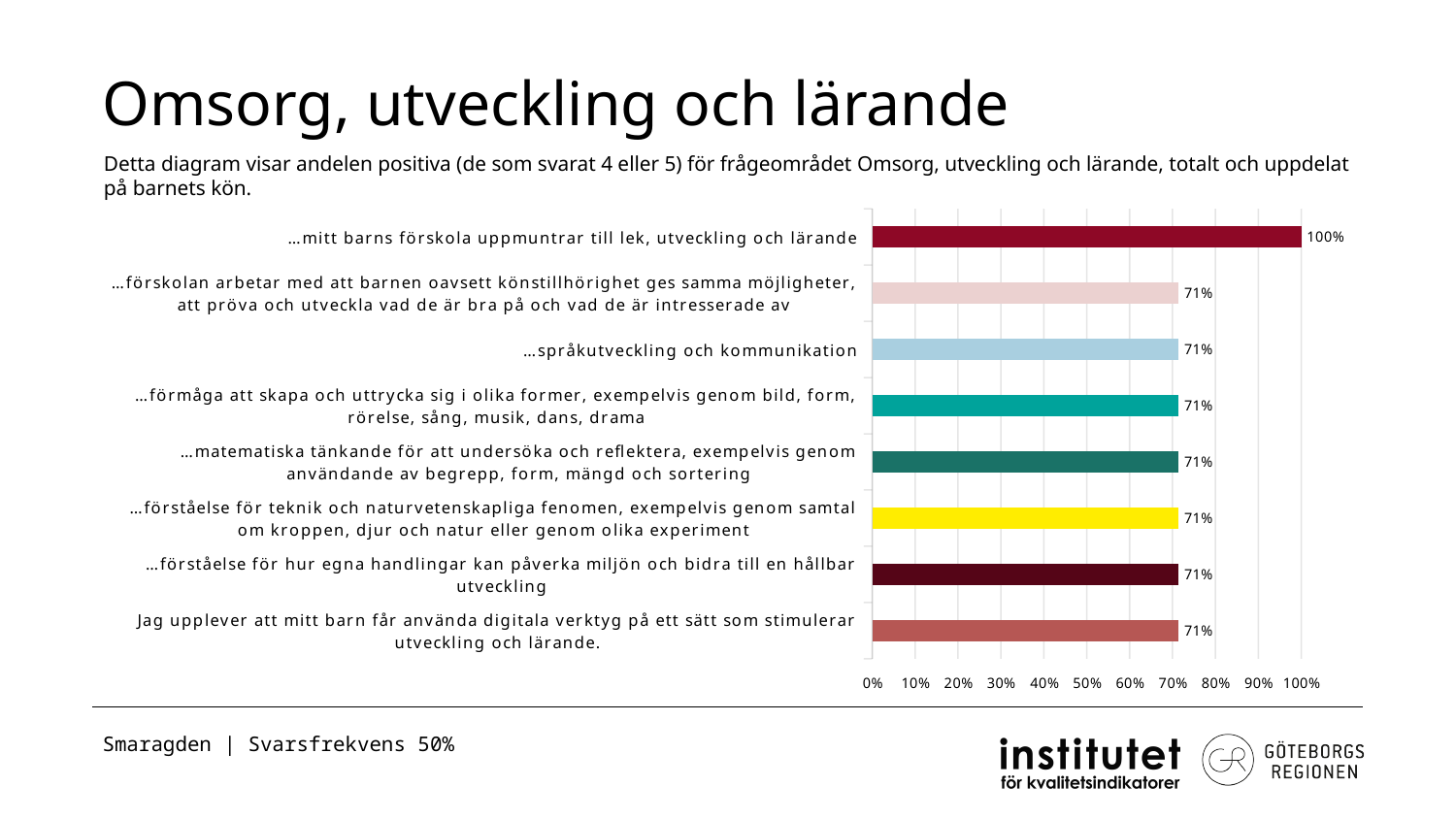
Is the value for "…förmåga att skapa och uttrycka sig i olika former, exempelvis genom bild, form, rörelse, sång, musik, dans, drama" greater or less than 50%? greater What is the value for "…mitt barns förskola uppmuntrar till lek, utveckling och lärande"? 100% Which category has the highest value? …mitt barns förskola uppmuntrar till lek, utveckling och lärande What is the difference between the value for "…mitt barns förskola uppmuntrar till lek, utveckling och lärande" and the value for "…språkutveckling och kommunikation"? 29% What kind of chart is shown on the slide? Bar chart Is the value for "…förståelse för teknik och naturvetenskapliga fenomen, exempelvis genom samtal om kroppen, djur och natur eller genom olika experiment" greater or less than 80%? less What is the value for "Jag upplever att mitt barn får använda digitala verktyg på ett sätt som stimulerar utveckling och lärande."? 71% How many categories are shown in the chart? 8 How many categories have a value of 71%? 7 What is the value for "…språkutveckling och kommunikation"? 71% Which is larger: the value for "…mitt barns förskola uppmuntrar till lek, utveckling och lärande" or the value for "…matematiska tänkande för att undersöka och reflektera, exempelvis genom användande av begrepp, form, mängd och sortering"? …mitt barns förskola uppmuntrar till lek, utveckling och lärande What is the value for "…förståelse för hur egna handlingar kan påverka miljön och bidra till en hållbar utveckling"? 71%